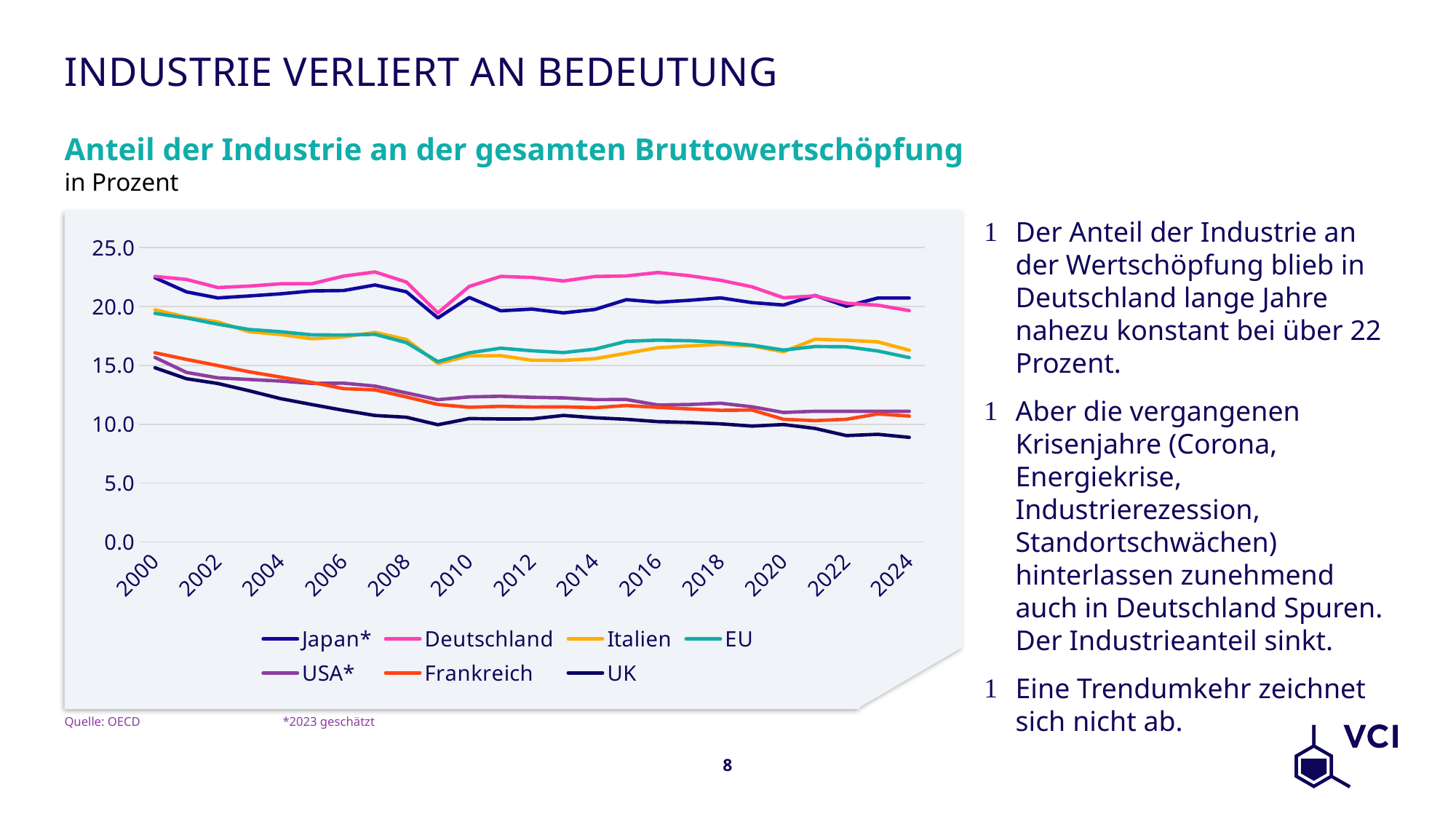
Which series has the lowest value in 2000? UK Is the value for UK in 2024 greater or less than 10.0? less Is the value for Deutschland in 2000 greater or less than 20.0? greater Which is larger in 2024, the value for Deutschland or the value for UK? Deutschland What kind of chart is shown on the slide? line chart Which series has the highest value in 2024? Japan* Is the value for EU in 2024 greater or less than 20.0? less How many series does the legend list? 7 Does the value for UK rise or fall from 2000 to 2024? fall Which series has the lowest value in 2024? UK What is the title of the chart? Anteil der Industrie an der gesamten Bruttowertschöpfung Which series is shown in pink in the legend? Deutschland